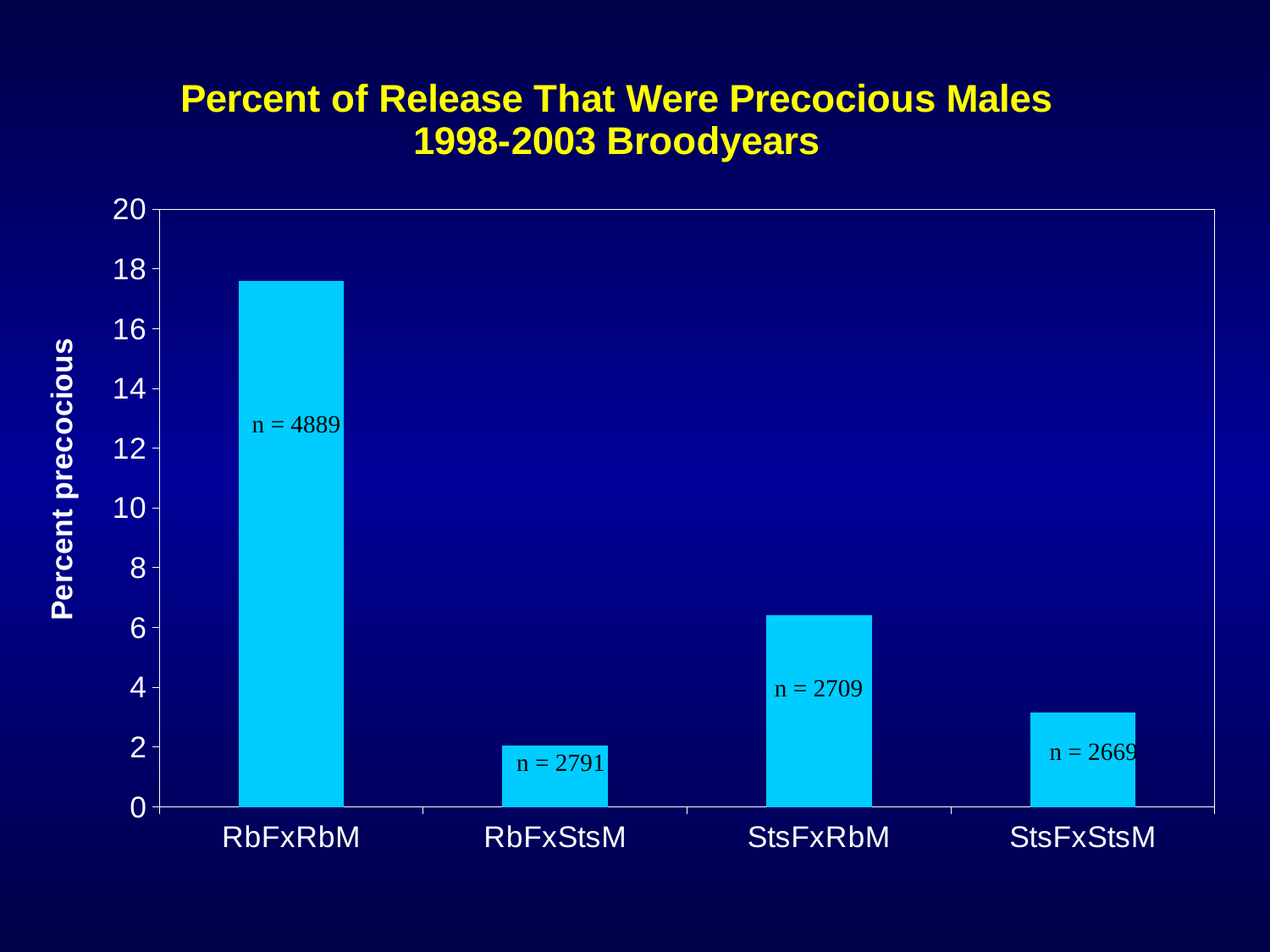
Is the percent precocious for RbFxStsM greater or less than 4? less Is the percent precocious for StsFxRbM greater or less than 4? greater Which has a higher percent precocious, StsFxRbM or StsFxStsM? StsFxRbM Which category has the highest percent precocious? RbFxRbM What is the sample size (n) printed on the StsFxStsM bar? n = 2669 Which category has the lowest percent precocious? RbFxStsM Is the percent precocious for RbFxRbM greater or less than 16? greater Which has a higher percent precocious, RbFxRbM or StsFxRbM? RbFxRbM What is the label on the y axis of the chart? Percent precocious What kind of chart is shown on the slide? bar chart How many categories are shown on the x axis of the chart? 4 What is the sample size (n) printed on the RbFxRbM bar? n = 4889